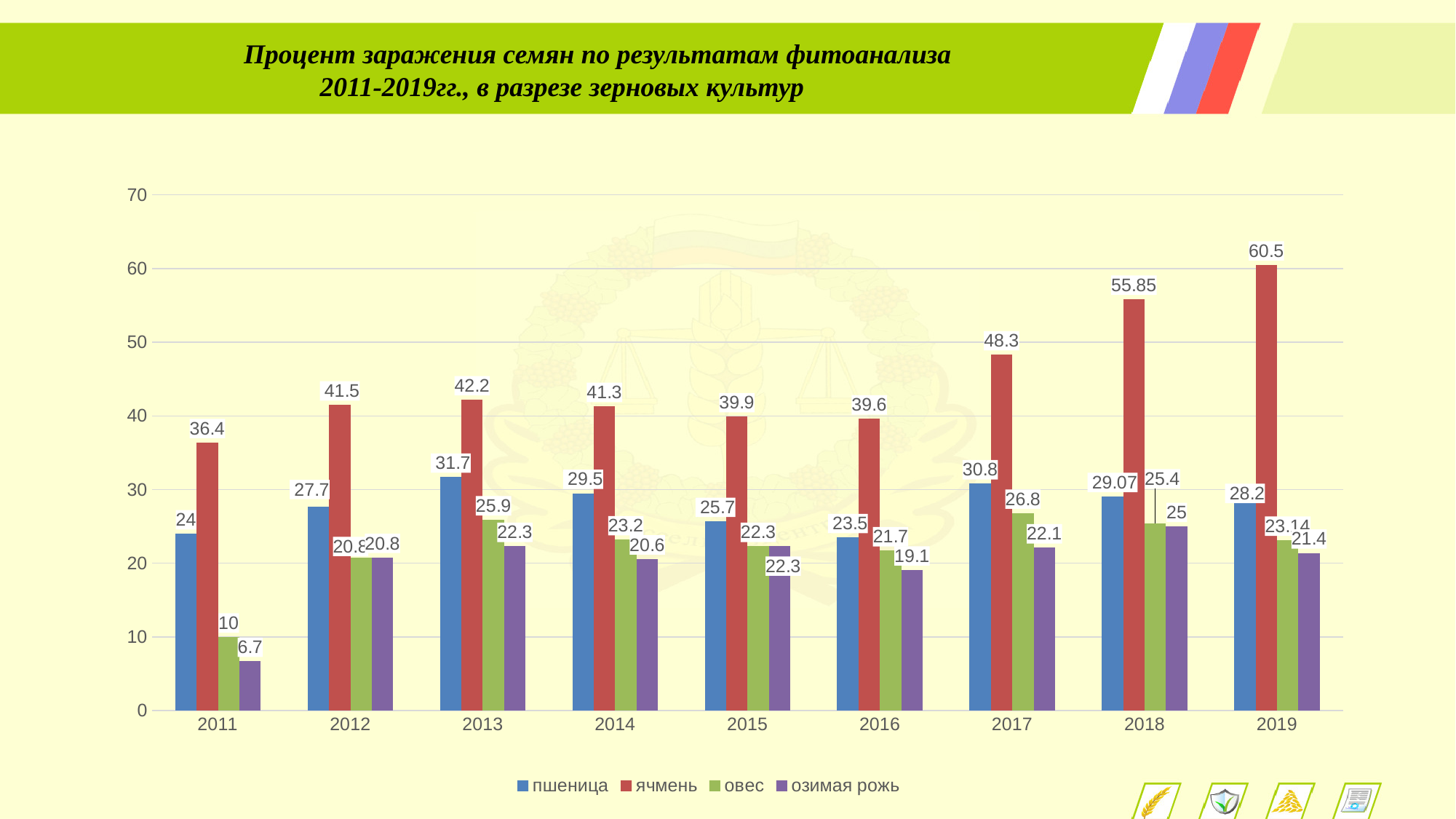
In which year is the value for ячмень highest? 2019 What is the value for пшеница in 2013? 31.7 Which is larger in 2017: the value for пшеница or the value for овес? пшеница What is the value for озимая рожь in 2011? 6.7 What is the difference between the ячмень value in 2019 and the ячмень value in 2018? 4.65 What type of chart is shown on the slide? bar chart How many series does the legend list? 4 In which year is the value for овес lowest? 2011 How many years are shown on the x axis? 9 Does the value for ячмень rise or fall from 2016 to 2019? rise What is the value for овес in 2018? 25.4 What is the value for ячмень in 2019? 60.5